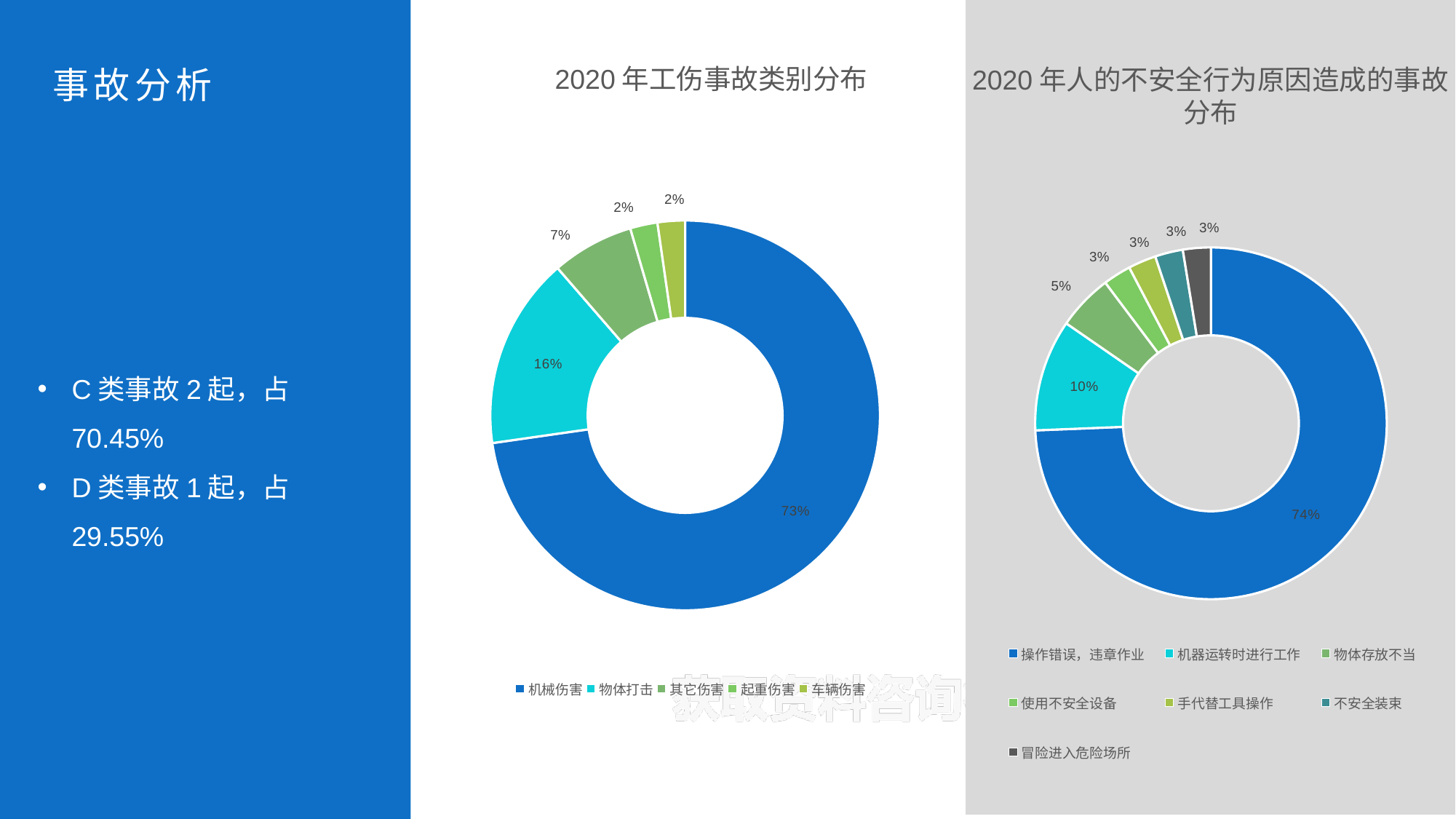
In the chart titled 2020年工伤事故类别分布, which category has the largest share? 机械伤害 In the chart titled 2020年工伤事故类别分布, what is the difference in percentage points between 机械伤害 and 物体打击? 57 In the chart titled 2020年人的不安全行为原因造成的事故分布, how many categories are listed in the legend? 7 What type of chart is the one titled 2020年工伤事故类别分布? Doughnut (pie) chart In the chart titled 2020年人的不安全行为原因造成的事故分布, which is larger: 机器运转时进行工作 or 物体存放不当? 机器运转时进行工作 In the chart titled 2020年工伤事故类别分布, what share does 物体打击 account for? 16% In the chart titled 2020年工伤事故类别分布, how many categories are shown in the legend? 5 In the chart titled 2020年工伤事故类别分布, what share does 机械伤害 account for? 73% In the chart titled 2020年人的不安全行为原因造成的事故分布, what share does 物体存放不当 account for? 5% In the chart titled 2020年人的不安全行为原因造成的事故分布, what share does 机器运转时进行工作 account for? 10% In the chart titled 2020年人的不安全行为原因造成的事故分布, what share does 操作错误，违章作业 account for? 74% In the chart titled 2020年工伤事故类别分布, what share does 其它伤害 account for? 7%